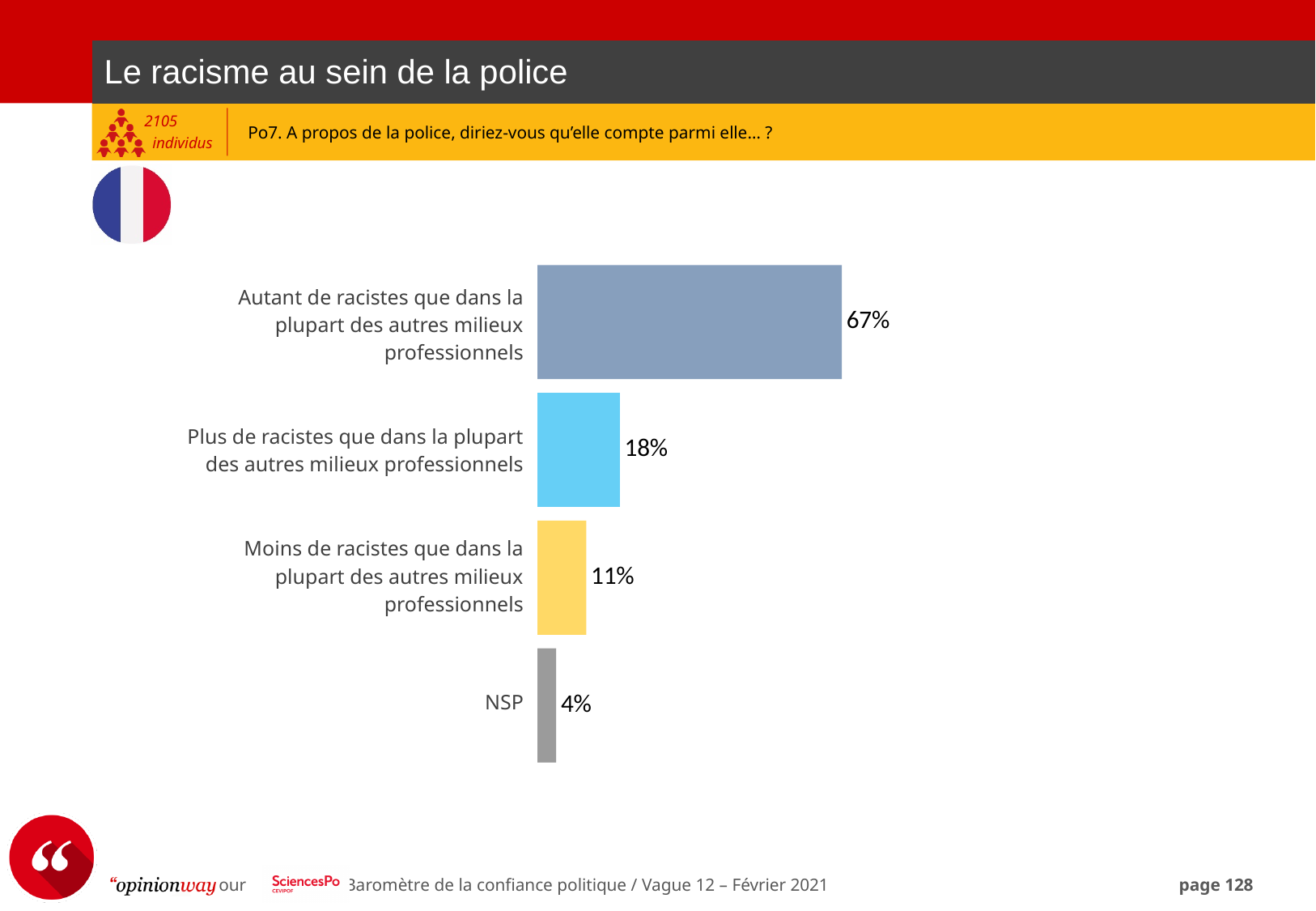
What is the difference between the 'Plus de racistes' value and the 'Moins de racistes' value? 7 percentage points What is the value for 'Moins de racistes que dans la plupart des autres milieux professionnels'? 11% Which is larger: the value for 'Plus de racistes' or the value for 'Moins de racistes'? Plus de racistes Which response category has the highest value? Autant de racistes que dans la plupart des autres milieux professionnels What is the difference between the 'Autant de racistes' value and the 'Plus de racistes' value? 49 percentage points What is the title of the slide? Le racisme au sein de la police How many response categories are shown in the chart? 4 What percentage of respondents said the police has 'Autant de racistes que dans la plupart des autres milieux professionnels'? 67% What percentage of respondents answered 'NSP'? 4% Which response category has the lowest value? NSP What kind of chart is shown on the slide? Bar chart What is the value for 'Plus de racistes que dans la plupart des autres milieux professionnels'? 18%